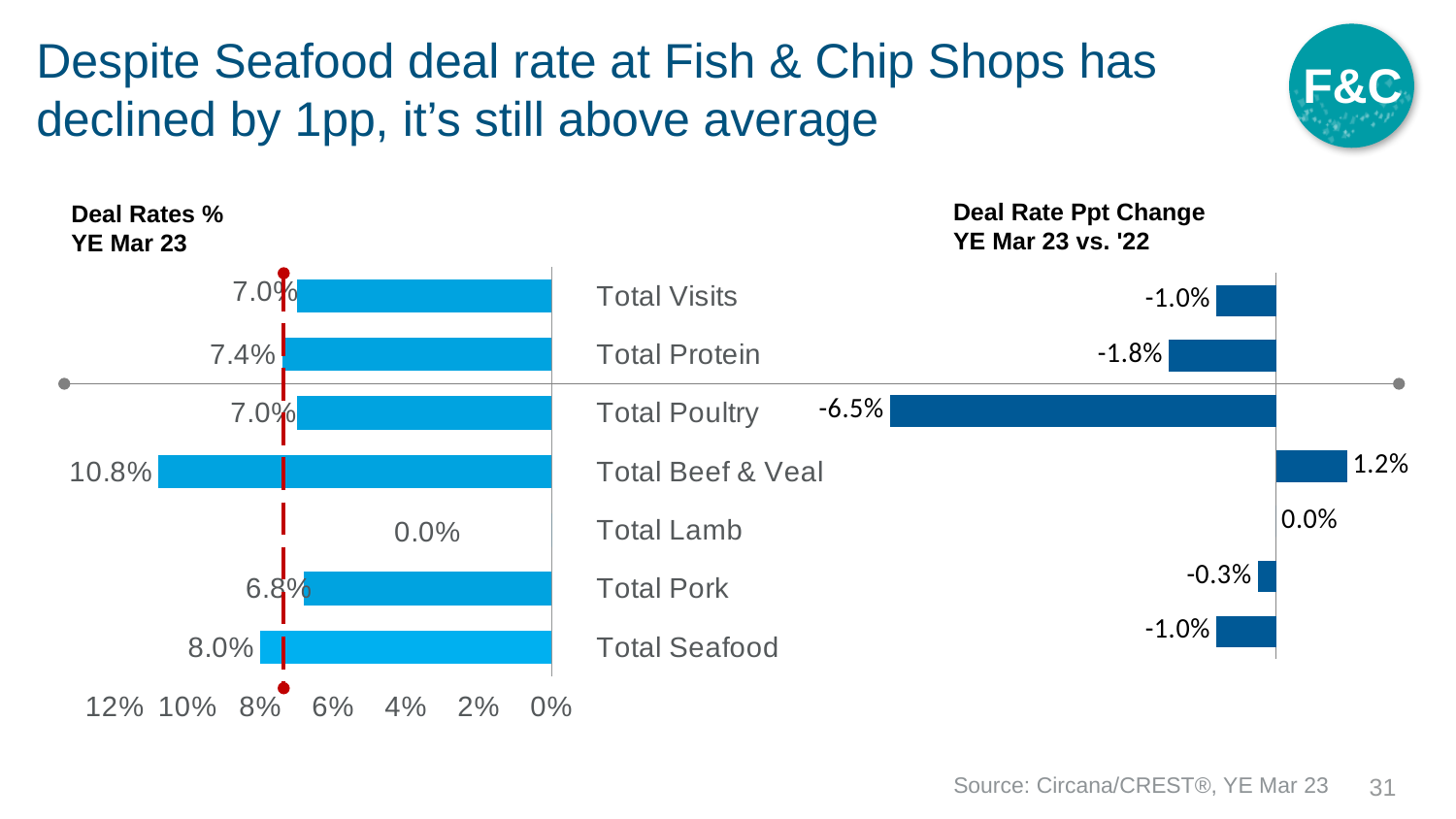
In the 'Deal Rates % YE Mar 23' chart, which category has the highest deal rate? Total Beef & Veal In the 'Deal Rate Ppt Change YE Mar 23 vs. '22' chart, what is the value for Total Seafood? -1.0% In the 'Deal Rates % YE Mar 23' chart, which is larger, Total Protein or Total Pork? Total Protein In the 'Deal Rates % YE Mar 23' chart, what is the value for Total Seafood? 8.0% In the 'Deal Rates % YE Mar 23' chart, what is the difference between Total Seafood and Total Visits? 1.0% How many categories are shown in the 'Deal Rates % YE Mar 23' chart? 7 In the 'Deal Rate Ppt Change YE Mar 23 vs. '22' chart, what is the value for Total Beef & Veal? 1.2% In the 'Deal Rates % YE Mar 23' chart, which category has the lowest deal rate? Total Lamb In the 'Deal Rate Ppt Change YE Mar 23 vs. '22' chart, what is the value for Total Poultry? -6.5% In the 'Deal Rates % YE Mar 23' chart, what is the value for Total Beef & Veal? 10.8% What type of chart is the 'Deal Rates % YE Mar 23' chart? Bar chart In the 'Deal Rate Ppt Change YE Mar 23 vs. '22' chart, which category has the largest decline? Total Poultry